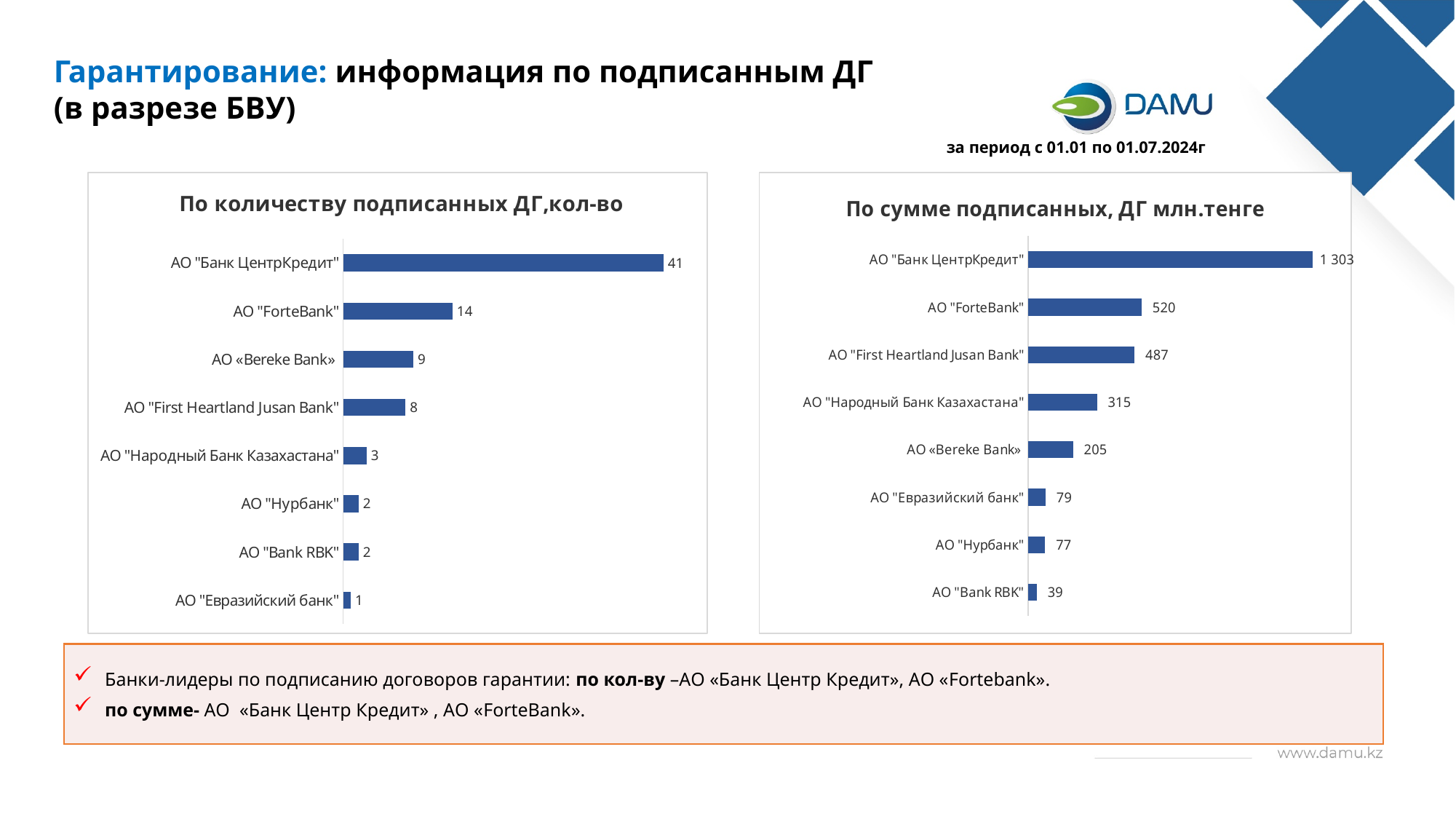
What kind of chart is "По сумме подписанных, ДГ млн.тенге"? Bar chart In the chart "По сумме подписанных, ДГ млн.тенге", what is the difference between АО "ForteBank" and АО «Bereke Bank»? 315 In the chart "По сумме подписанных, ДГ млн.тенге", what is the value for АО "Банк ЦентрКредит"? 1 303 In the chart "По количеству подписанных ДГ,кол-во", what is the value for АО "ForteBank"? 14 What is the title of the left chart on the slide? По количеству подписанных ДГ,кол-во In the chart "По сумме подписанных, ДГ млн.тенге", which is larger: АО "Народный Банк Казахастана" or АО «Bereke Bank»? АО "Народный Банк Казахастана" In the chart "По сумме подписанных, ДГ млн.тенге", which bank has the lowest value? АО "Bank RBK" In the chart "По количеству подписанных ДГ,кол-во", what is the difference between АО "Банк ЦентрКредит" and АО "ForteBank"? 27 How many banks are shown in the chart "По количеству подписанных ДГ,кол-во"? 8 In the chart "По количеству подписанных ДГ,кол-во", which is larger: АО «Bereke Bank» or АО "First Heartland Jusan Bank"? АО «Bereke Bank» In the chart "По количеству подписанных ДГ,кол-во", which bank has the highest value? АО "Банк ЦентрКредит" In the chart "По сумме подписанных, ДГ млн.тенге", what is the value for АО "First Heartland Jusan Bank"? 487